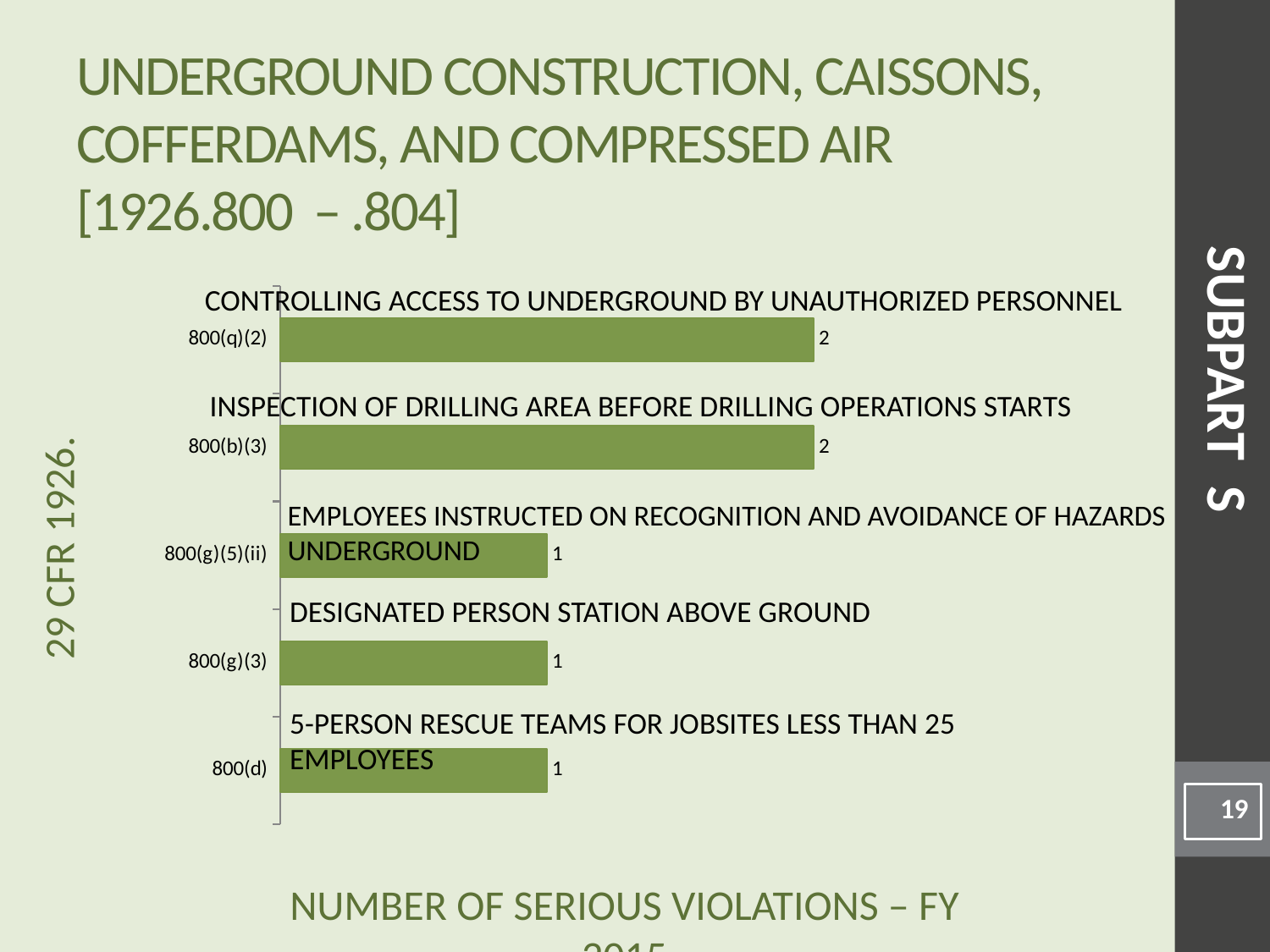
What is the difference between the values for 800(q)(2) and 800(d)? 1 What is the number of serious violations for 800(g)(3)? 1 What is the number of serious violations for 800(q)(2)? 2 What is the number of serious violations for 800(g)(5)(ii)? 1 What kind of chart is shown on the slide? bar chart What is the number of serious violations for 800(d)? 1 What colour are the bars in the chart? green What is the number of serious violations for 800(b)(3)? 2 How many categories (standards) are plotted in the chart? 5 What is the total of all the values plotted in the chart? 7 How many categories in the chart have a value of 1? 3 Which has more serious violations, 800(b)(3) or 800(g)(3)? 800(b)(3)